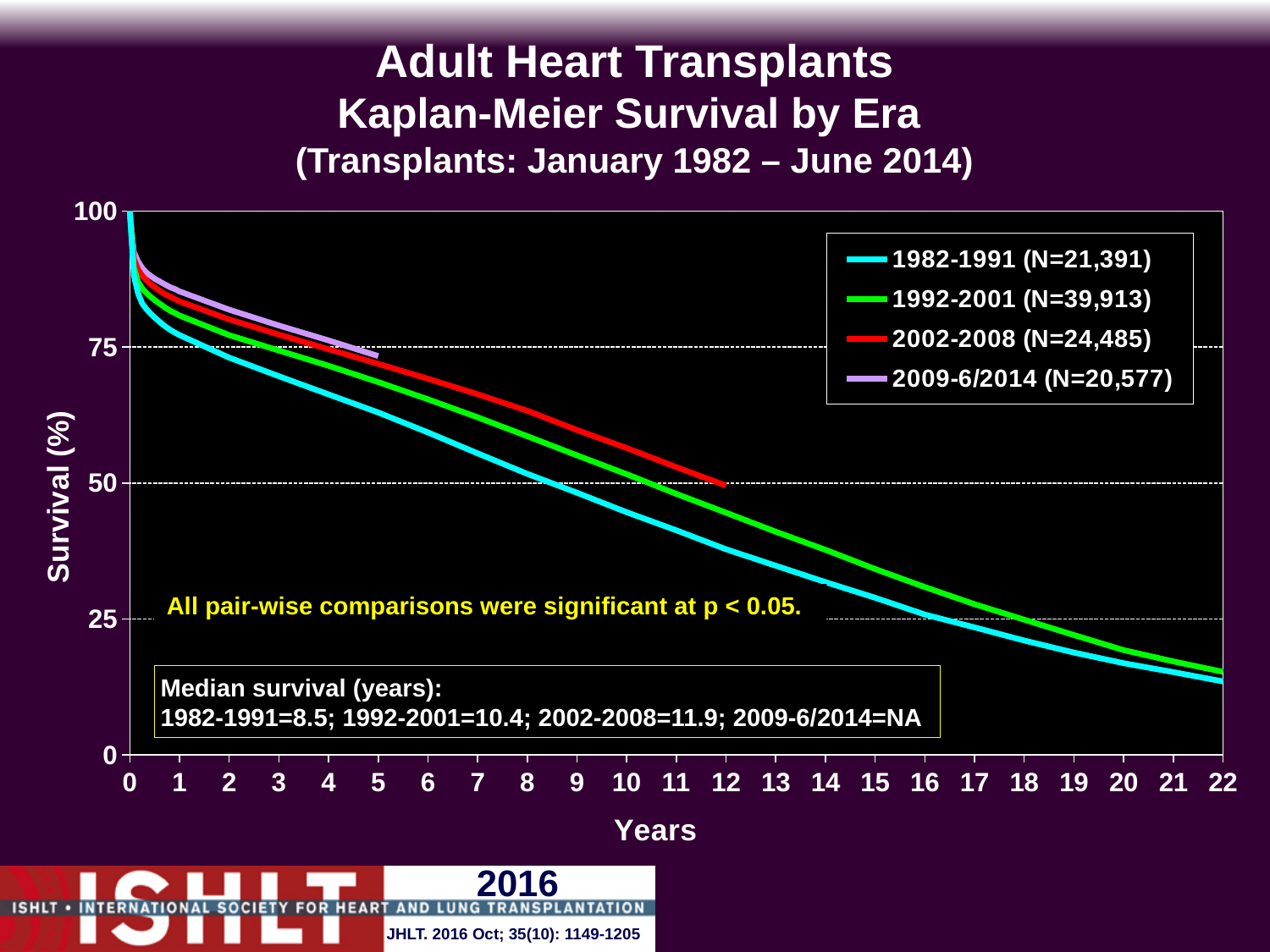
Is the survival for the 1992-2001 era at 5 years greater or less than 50? greater What is the median survival given for the 2009-6/2014 era? NA What kind of chart is shown on the slide? line chart Is the survival for the 1982-1991 era at 10 years greater or less than 50? less What is the N shown in the legend for the 1992-2001 era? 39,913 What is the median survival in years for the 1982-1991 era? 8.5 What is the median survival in years for the 1992-2001 era? 10.4 Do the survival curves rise or fall as years increase? fall How many series (eras) does the legend list? 4 At 5 years, which era has higher survival: 1982-1991 or 2002-2008? 2002-2008 What is the difference in median survival (years) between the 2002-2008 era and the 1982-1991 era? 3.4 What is the median survival in years for the 2002-2008 era? 11.9